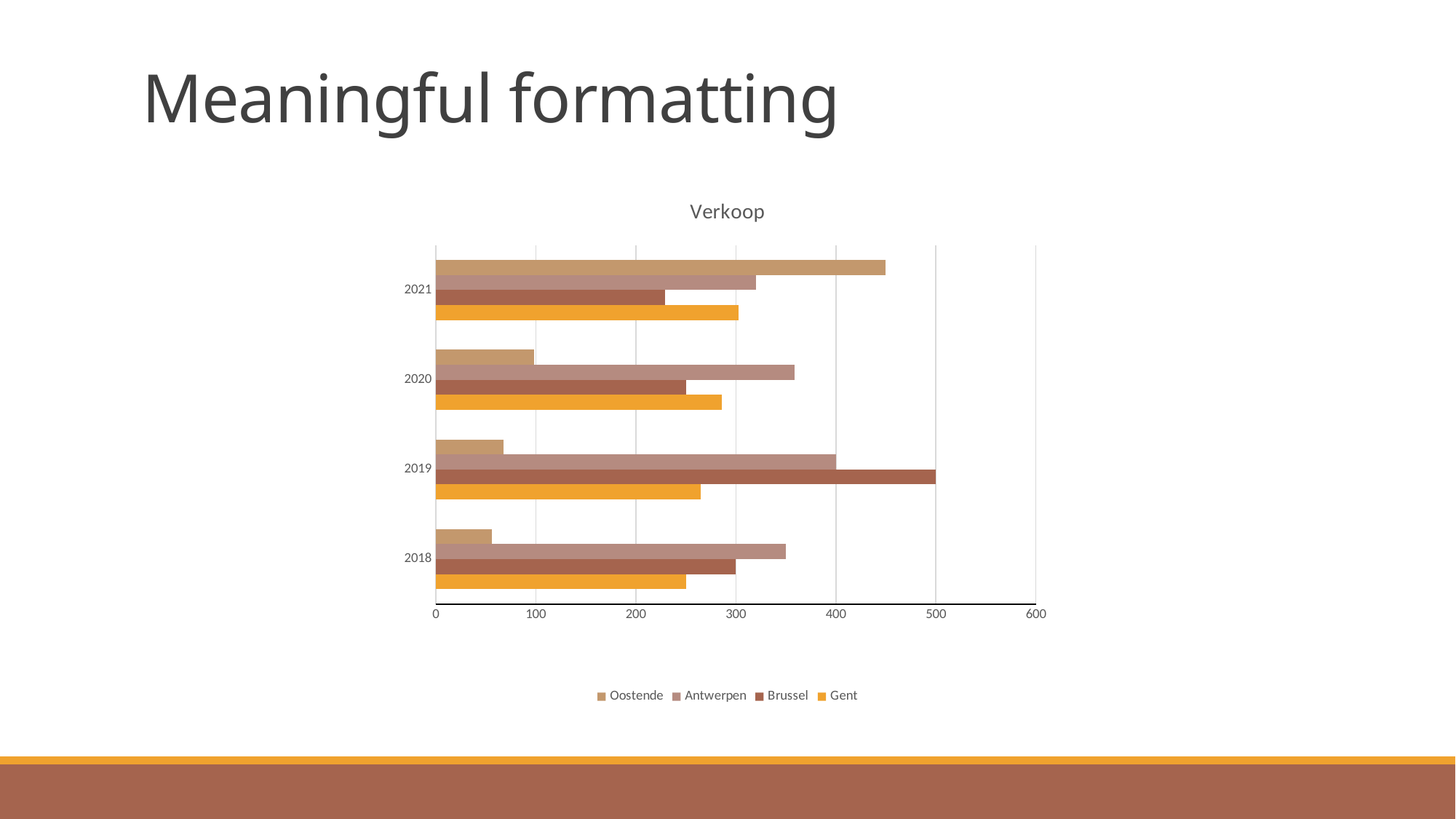
How many series does the legend list? 4 Which is larger in 2020, the value for Antwerpen or the value for Brussel? Antwerpen Which series has the highest value in 2021? Oostende How many years are shown on the category axis? 4 What is the title of the chart? Verkoop What is the value for Antwerpen in 2019? 400 Do the values for Oostende rise or fall from 2018 to 2021? rise Which series has the lowest value in 2019? Oostende Is the value for Oostende in 2021 greater or less than 400? greater What kind of chart is shown on the slide? bar chart What is the value for Brussel in 2019? 500